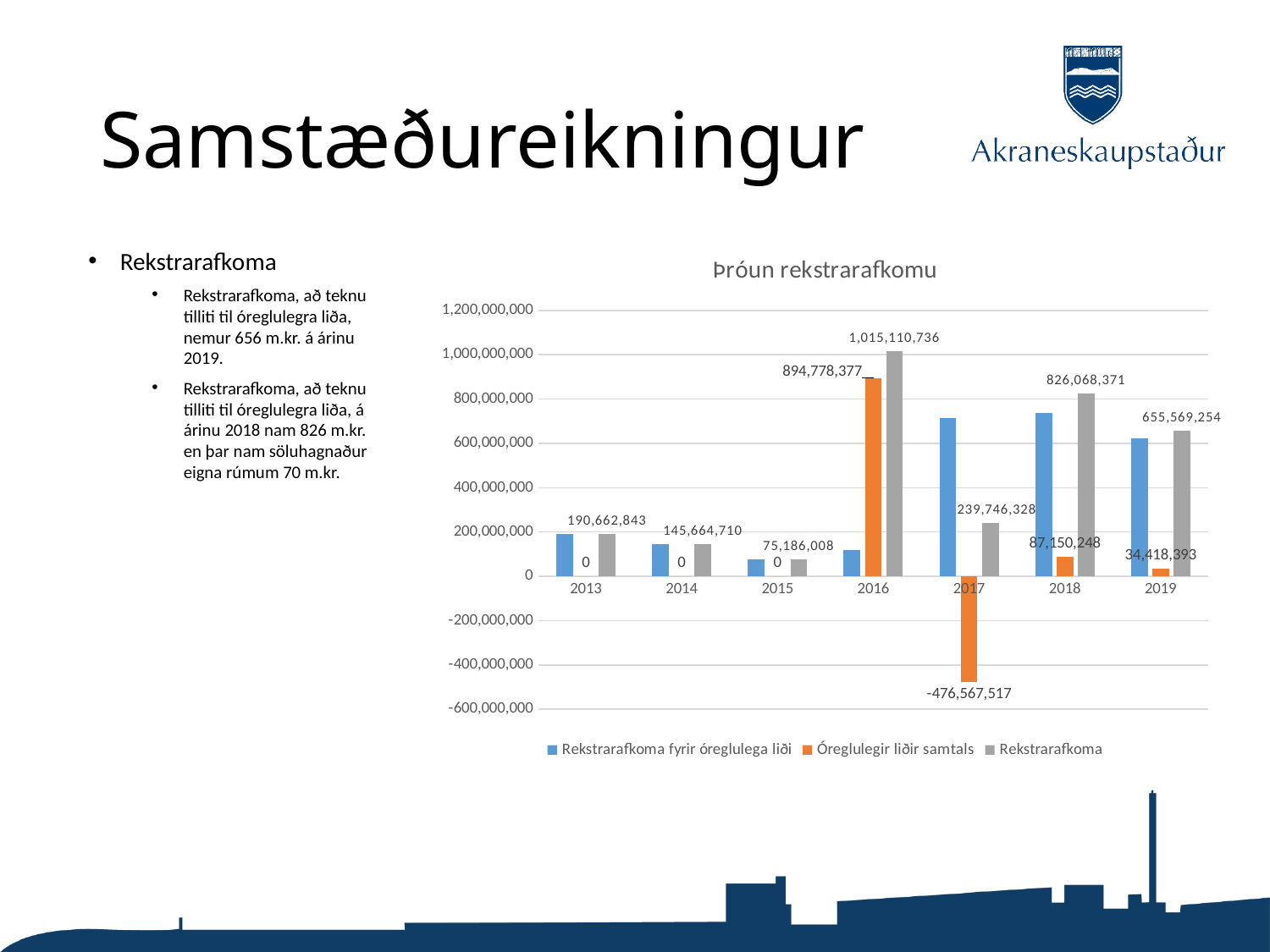
Does Rekstrarafkoma rise or fall from 2013 to 2015? fall In which year is Rekstrarafkoma lowest? 2015 How many years are shown on the x axis? 7 How many series does the legend list? 3 What kind of chart is shown? bar chart What is the difference between Rekstrarafkoma in 2018 and in 2019? 170,499,117 In which year is Rekstrarafkoma highest? 2016 Is the value for Rekstrarafkoma fyrir óreglulega liði in 2018 greater or less than 600,000,000? greater What is the value of Rekstrarafkoma for 2019? 655,569,254 Which year has the larger Rekstrarafkoma, 2013 or 2014? 2013 What is the value of Óreglulegir liðir samtals for 2017? -476,567,517 What is the value of Rekstrarafkoma for 2016? 1,015,110,736